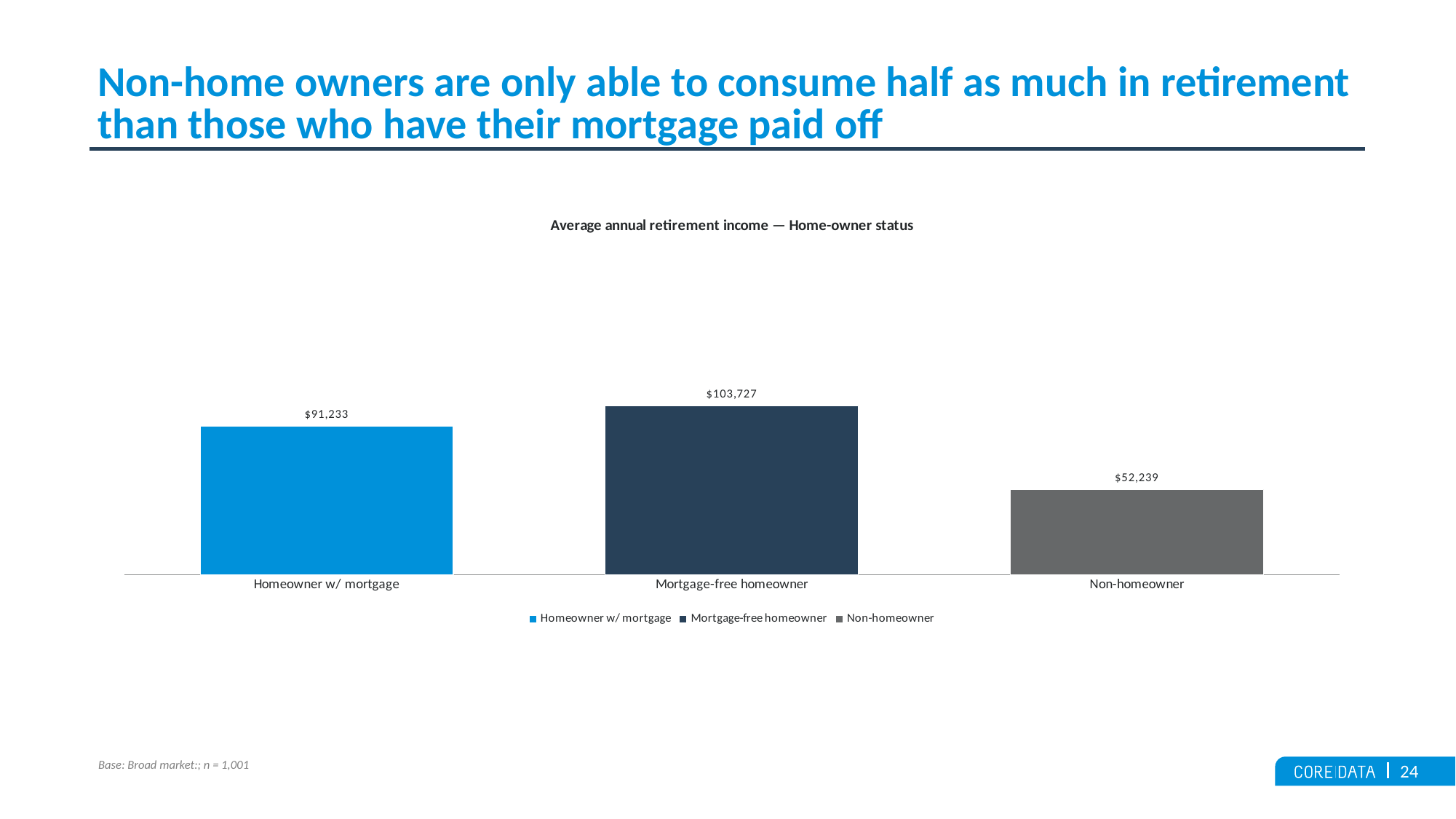
Which has a higher average annual retirement income, Homeowner w/ mortgage or Non-homeowner? Homeowner w/ mortgage Which home-owner status has the lowest average annual retirement income? Non-homeowner What kind of chart is shown on the slide? Bar chart What is the average annual retirement income for Mortgage-free homeowner? $103,727 What is the difference in average annual retirement income between Mortgage-free homeowner and Non-homeowner? $51,488 Which home-owner status has the highest average annual retirement income? Mortgage-free homeowner What is the average annual retirement income for Homeowner w/ mortgage? $91,233 What is the average annual retirement income for Non-homeowner? $52,239 What is the difference in average annual retirement income between Mortgage-free homeowner and Homeowner w/ mortgage? $12,494 How many home-owner status categories are shown in the chart? 3 What is the title of the chart? Average annual retirement income — Home-owner status How many entries does the chart legend list? 3